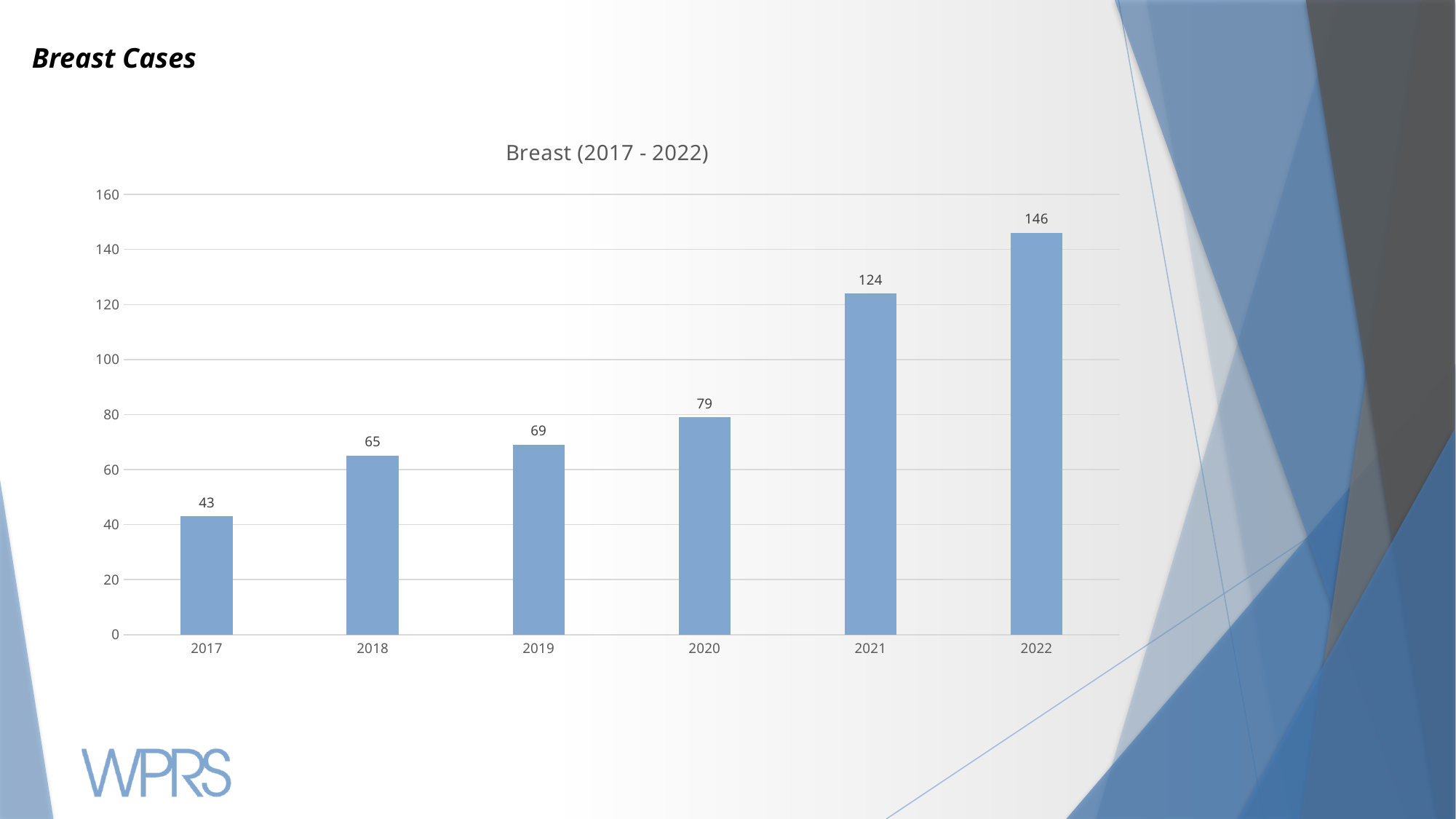
What is the difference between the values for 2018 and 2017? 22 What is the value for 2020? 79 What is the value for 2017? 43 How many years are shown on the x axis? 6 Is the value for 2021 greater or less than 100? greater Which year has the lowest value? 2017 Do the values rise or fall from 2017 to 2022? rise What kind of chart is shown? bar chart What is the difference between the values for 2022 and 2021? 22 Which is larger, the value for 2019 or the value for 2020? 2020 What is the value for 2022? 146 Which year has the highest value? 2022